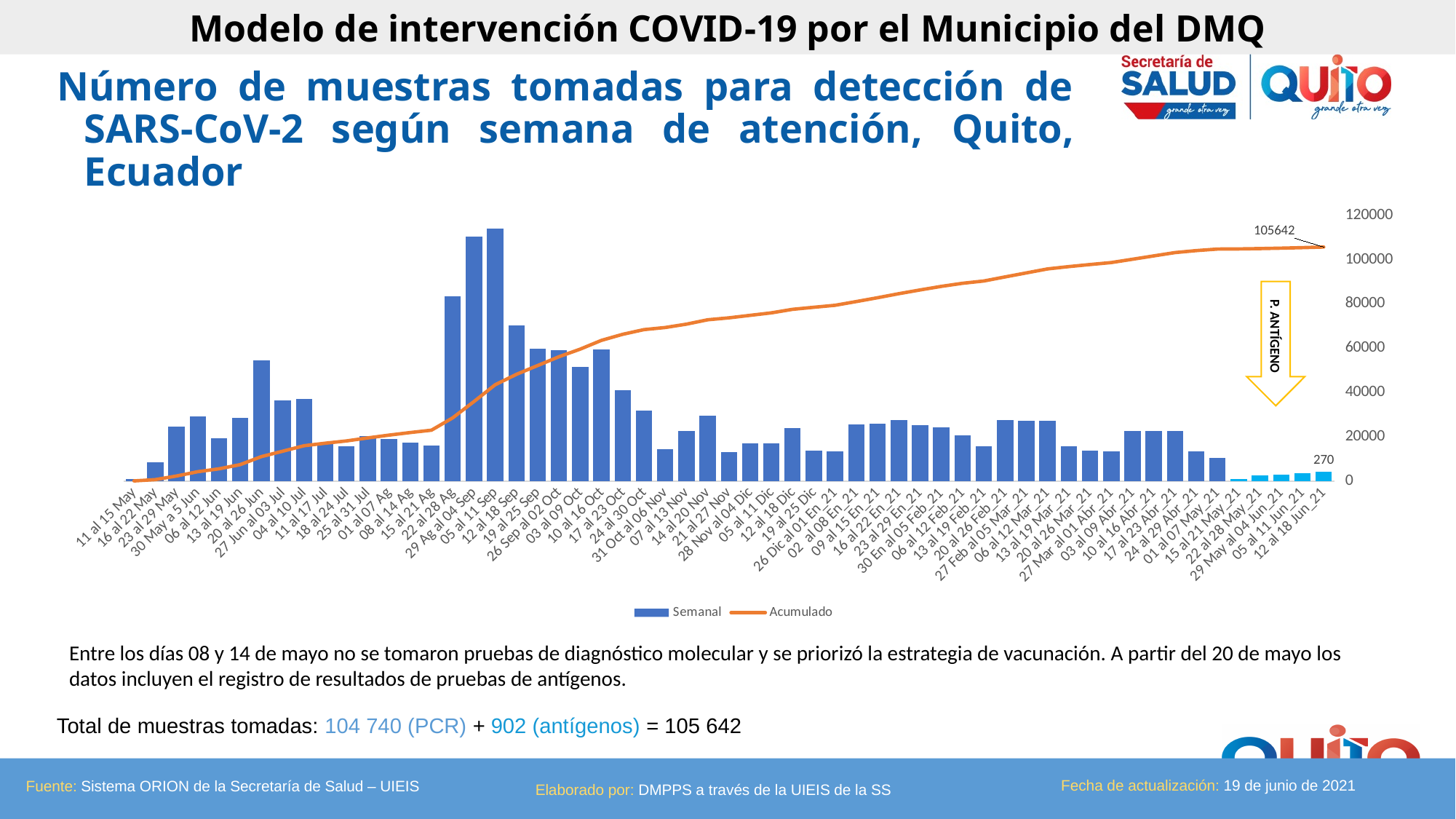
What colour are the Semanal bars in the chart? Blue How many series does the legend list? 2 Which Semanal bar is taller: 20 al 26 Jun or 13 al 19 Jun? 20 al 26 Jun Does the Acumulado line rise or fall from left to right along the x axis? Rises What kind of chart is shown on the slide? A combined bar and line chart Which Semanal bar is taller: 29 Ag al 04 Sep or 19 al 25 Sep? 29 Ag al 04 Sep Is the Acumulado value for 12 al 18 Jun_21 greater or less than 100000? greater What is the data label shown on the Semanal bar for 12 al 18 Jun_21? 270 What is the data label shown on the last point of the Acumulado line (12 al 18 Jun_21)? 105642 What are the two series named in the legend? Semanal and Acumulado